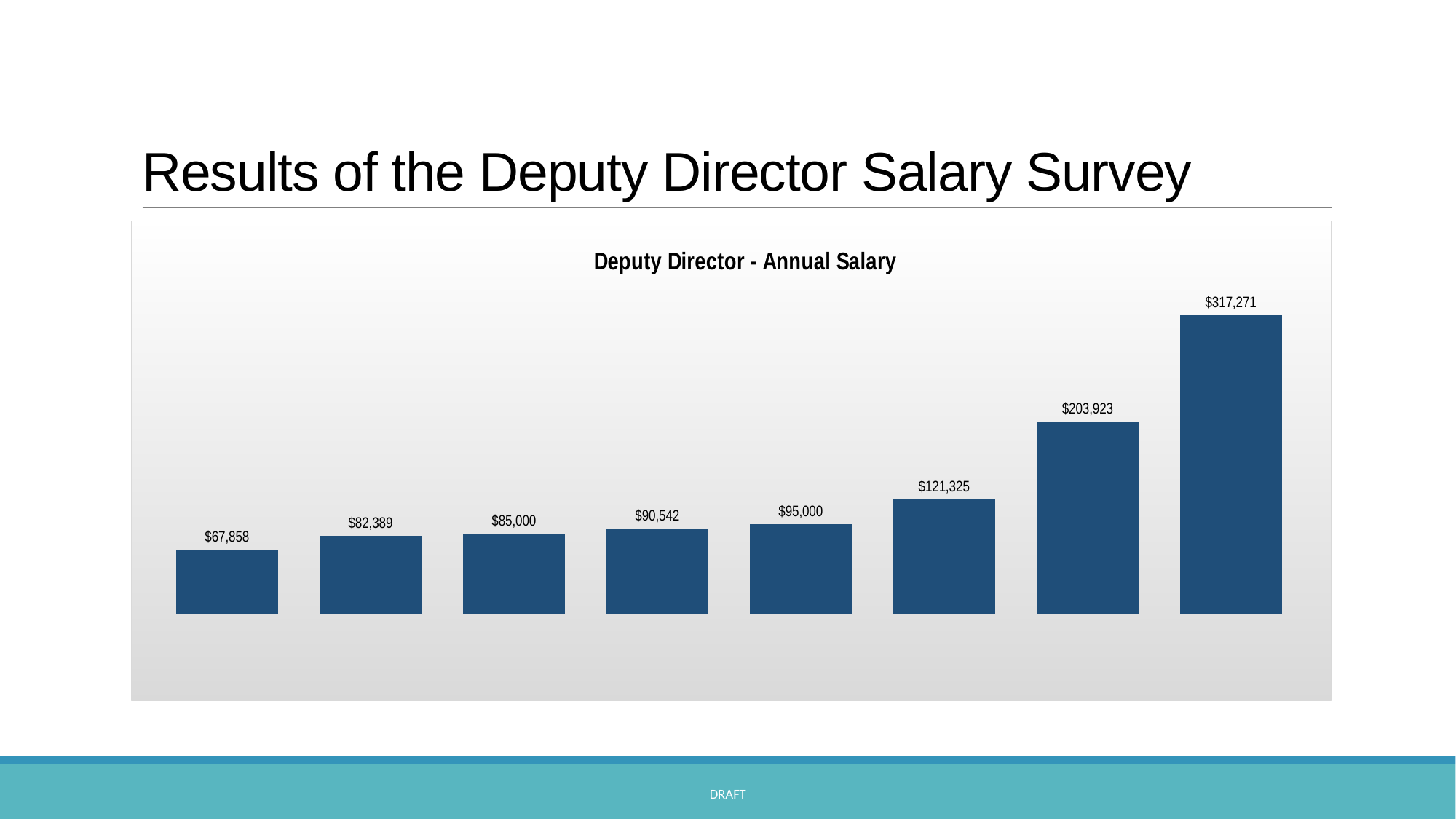
What is the highest salary value shown in the chart? $317,271 How many bars are plotted in the chart? 8 What is the difference between the rightmost bar ($317,271) and the second-from-right bar ($203,923)? $113,348 Do the bar values rise or fall from left to right across the chart? rise What is the lowest salary value shown in the chart? $67,858 What is the value shown on the third bar from the left? $85,000 What is the title of the chart? Deputy Director - Annual Salary What is the value shown on the rightmost bar? $317,271 What is the value shown on the leftmost bar? $67,858 What is the value shown on the sixth bar from the left? $121,325 What kind of chart is shown on the slide? bar chart Which is larger, the fifth bar from the left or the fourth bar from the left? the fifth bar ($95,000)